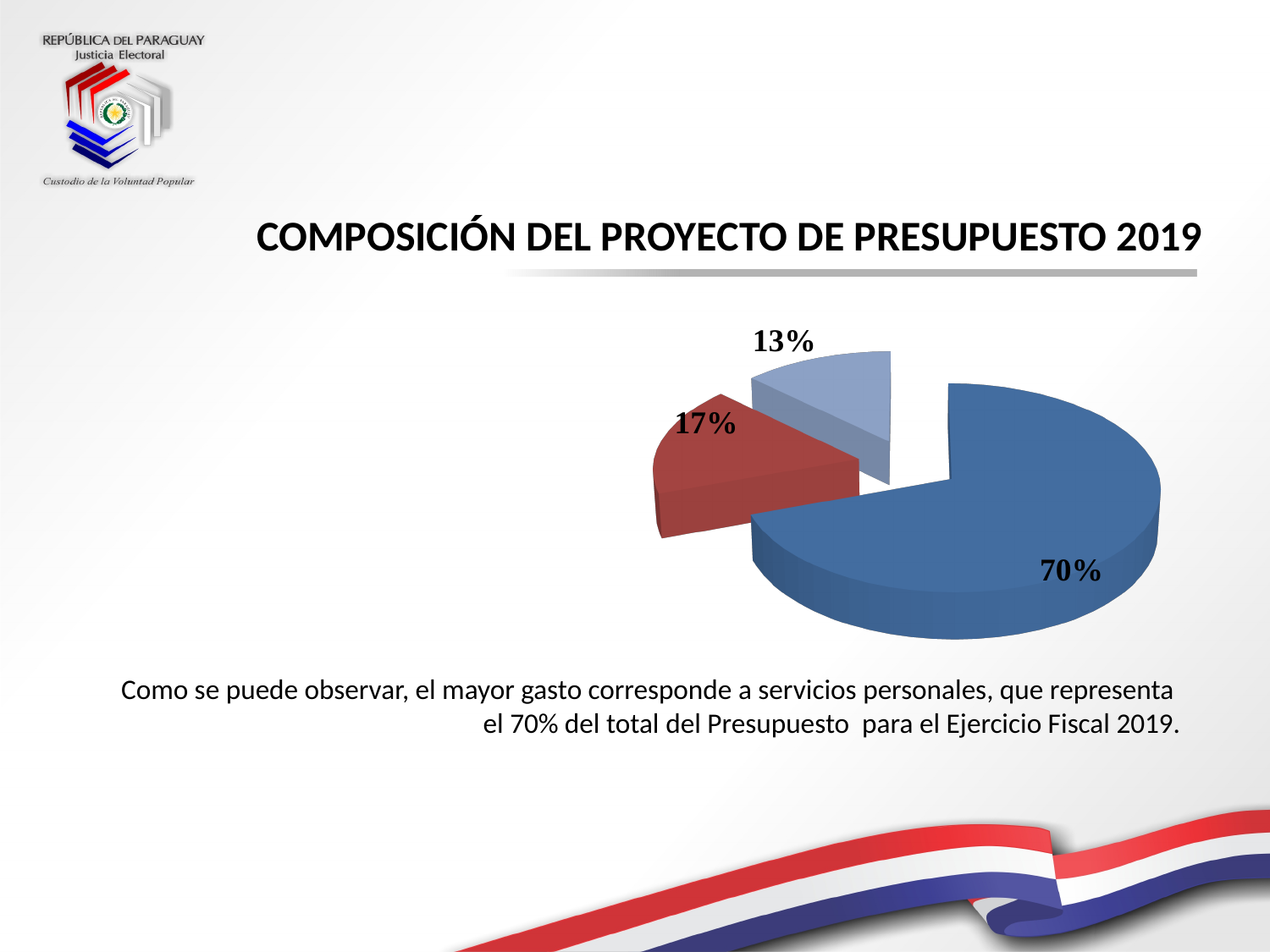
Which slice is larger, the red one or the light blue one? the red one What is the title of the slide containing the pie chart? COMPOSICIÓN DEL PROYECTO DE PRESUPUESTO 2019 What is the difference in percentage points between the red slice and the light blue slice? 4 What percentage does the red slice of the pie chart represent? 17% What is the largest share shown in the pie chart? 70% What percentage does the blue slice of the pie chart represent? 70% According to the slide, what share of the 2019 budget corresponds to servicios personales? 70% What is the smallest share shown in the pie chart? 13% What percentage does the light blue slice of the pie chart represent? 13% What is the difference in percentage points between the largest slice and the red slice? 53 What kind of chart is shown on the slide? pie chart How many slices does the pie chart have? 3